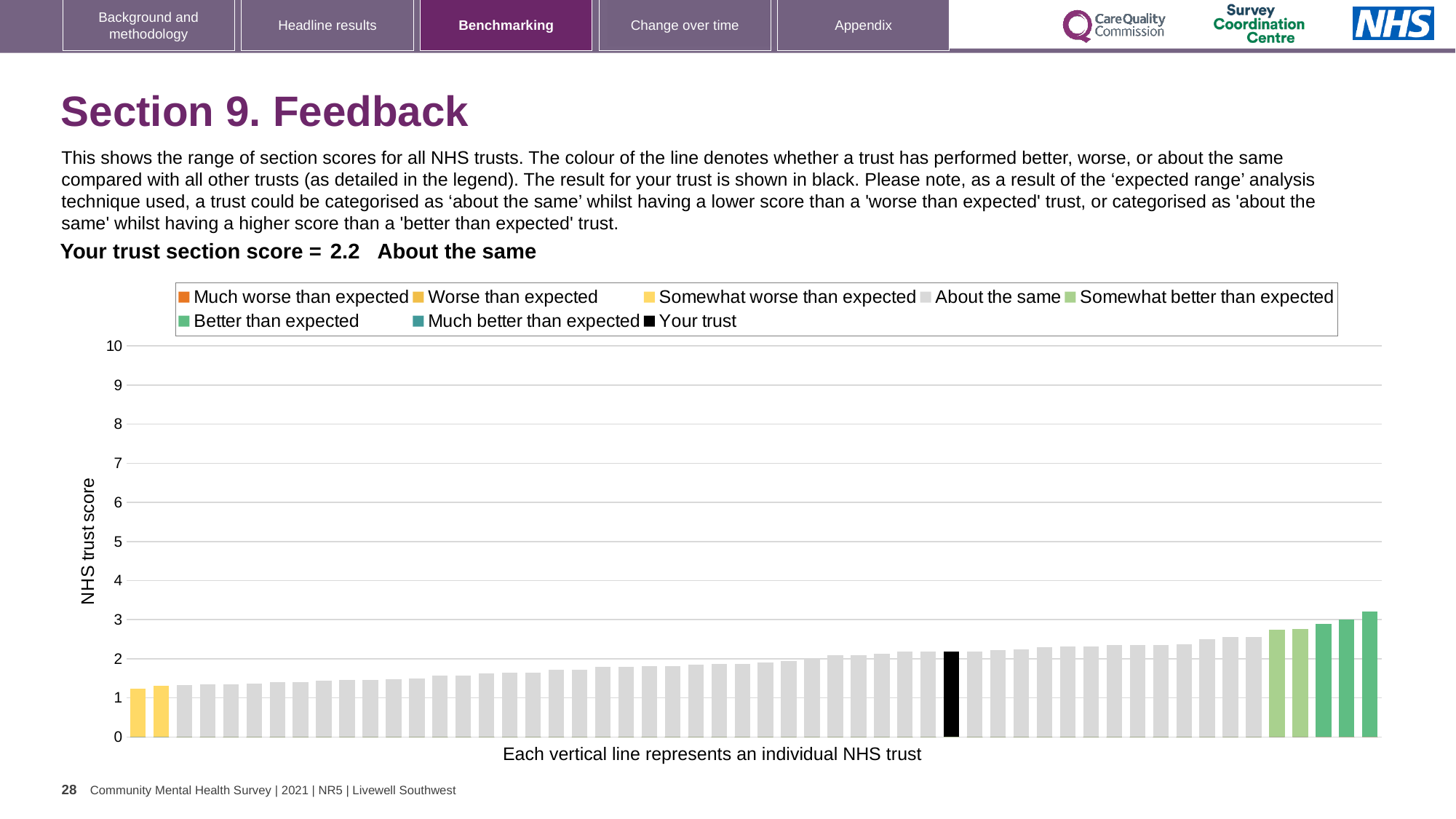
Do the bar values rise or fall from left to right along the x axis? rise Is the value for your trust (the black bar) greater or less than 3? less How many bars are shown in black for 'Your trust'? 1 Is the value of the lowest bar greater or less than 2? less What is the section score for your trust? 2.2 What colour is used for the 'Your trust' bar? black What kind of chart is shown on the slide? bar chart Is the value of the highest bar greater or less than 4? less How many bars are coloured as 'Somewhat worse than expected' (yellow)? 2 What is the label on the vertical axis? NHS trust score How many entries does the legend list? 8 Which category is your trust's section score placed in? About the same